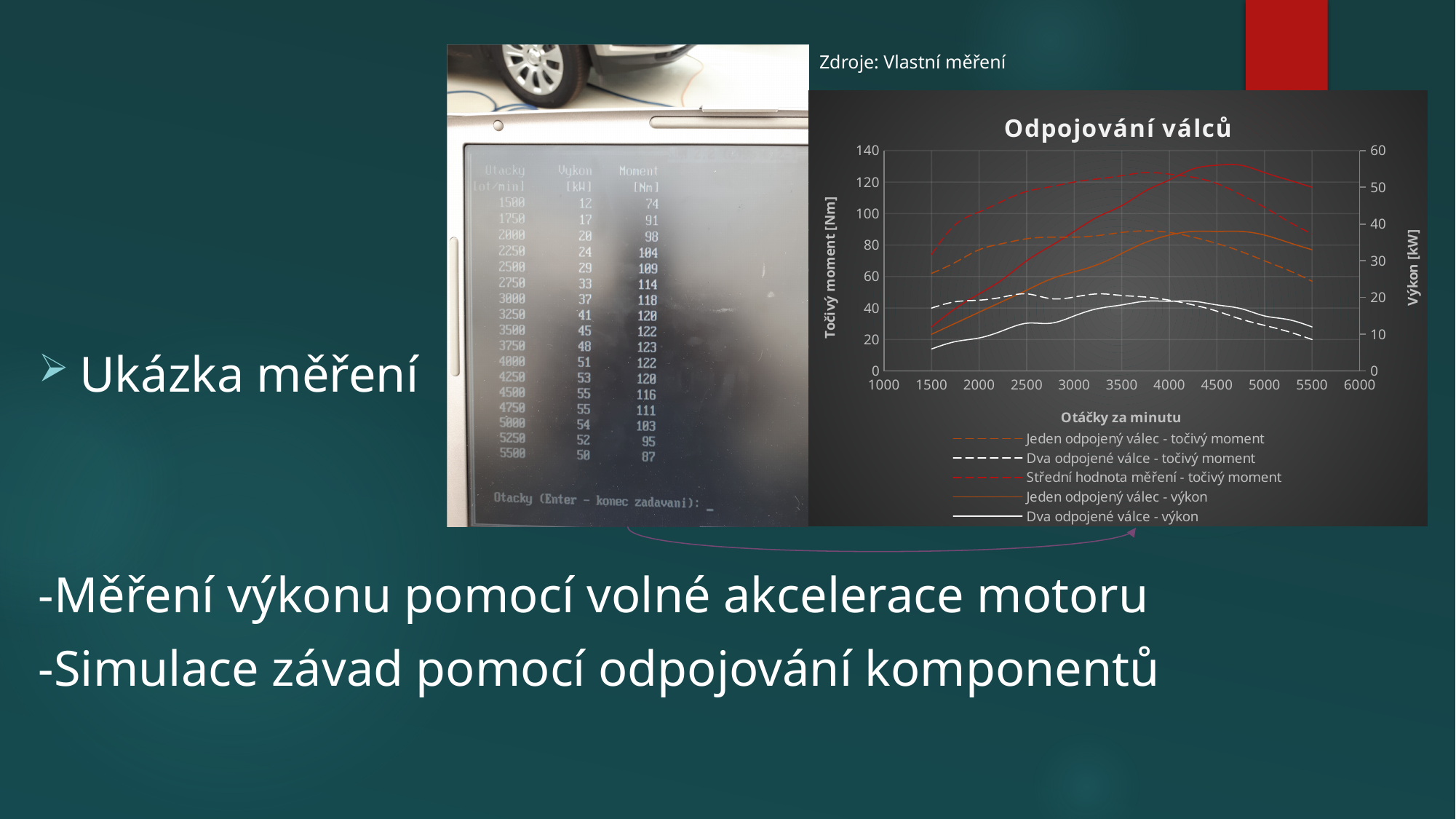
In the "Odpojování válců" chart, at 5000 rpm, which is higher: "Jeden odpojený válec - točivý moment" or "Dva odpojené válce - točivý moment"? Jeden odpojený válec - točivý moment In the "Odpojování válců" chart, is the value of "Střední hodnota měření - točivý moment" at 3500 greater or less than 100? greater What kind of chart is "Odpojování válců"? line chart In the "Odpojování válců" chart, is the value of "Jeden odpojený válec - točivý moment" at 4000 greater or less than 60? greater How many series does the legend of the "Odpojování válců" chart list? 5 In the "Odpojování válců" chart, is the value of "Jeden odpojený válec - výkon" at 1500 greater or less than 20 kW on the right axis? less What is the label of the x axis of the "Odpojování válců" chart? Otáčky za minutu What is the title of the chart on the slide? Odpojování válců In the "Odpojování válců" chart, does "Dva odpojené válce - výkon" rise or fall between 4500 and 5500 rpm? fall In the "Odpojování válců" chart, does "Jeden odpojený válec - výkon" rise or fall between 1500 and 4000 rpm? rise In the "Odpojování válců" chart, at 3000 rpm, which is higher: "Střední hodnota měření - točivý moment" or "Jeden odpojený válec - točivý moment"? Střední hodnota měření - točivý moment